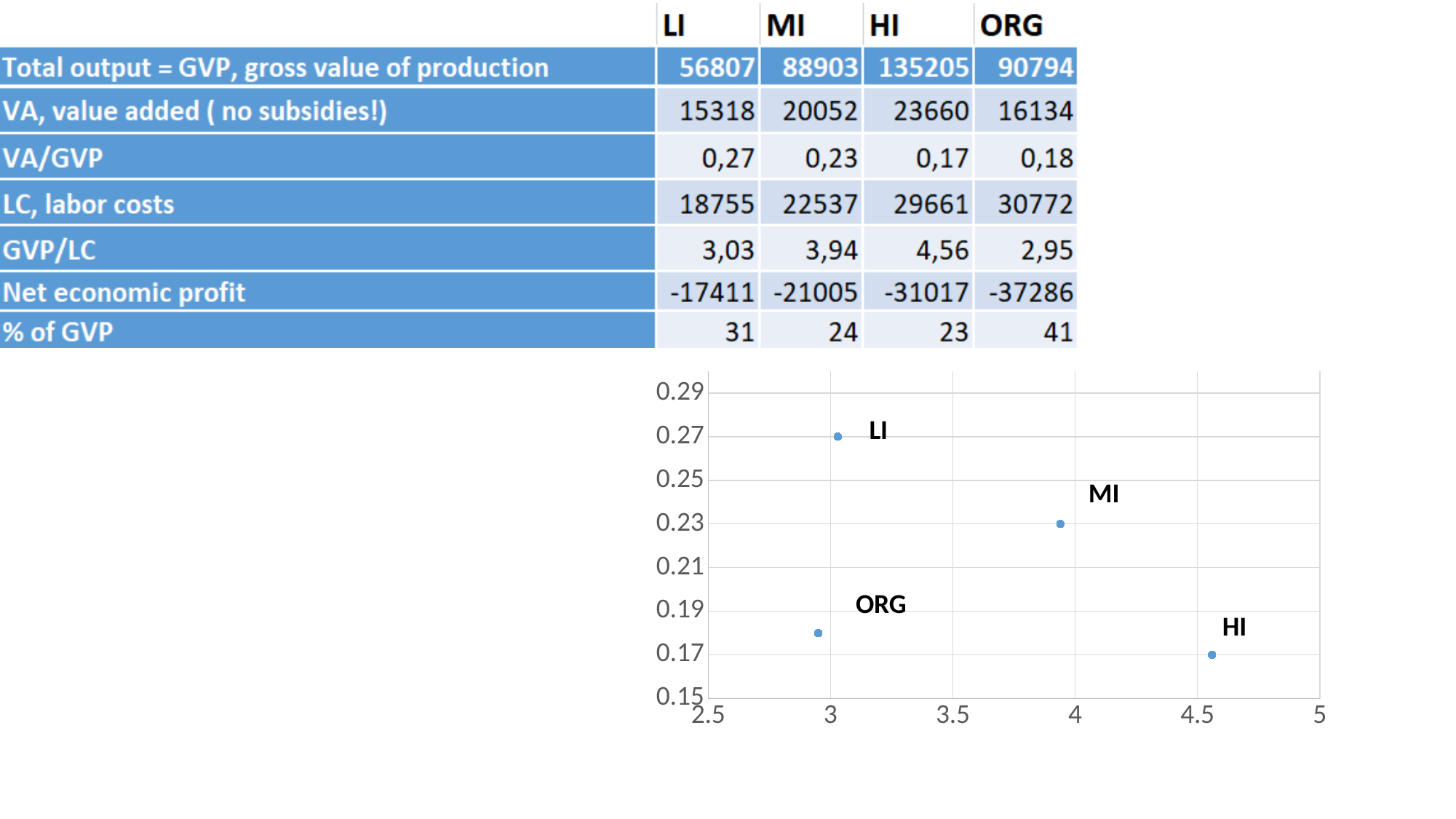
How many data points are plotted in the scatter chart? 4 In the scatter chart, is the vertical-axis value for ORG greater or less than 0.21? less What kind of chart is shown on the slide? scatter chart Which labelled point in the scatter chart has the highest vertical-axis value? LI In the scatter chart, what is the vertical-axis value of the point labelled MI? 0.23 Which labelled point is furthest to the right in the scatter chart? HI In the scatter chart, is the horizontal-axis value for HI greater or less than 4? greater In the scatter chart, which point has a higher vertical-axis value, LI or MI? LI In the scatter chart, is the horizontal-axis value for MI greater or less than 3.5? greater In the scatter chart, what is the vertical-axis value of the point labelled HI? 0.17 In the scatter chart, what is the vertical-axis value of the point labelled LI? 0.27 Which labelled point in the scatter chart has the lowest vertical-axis value? HI